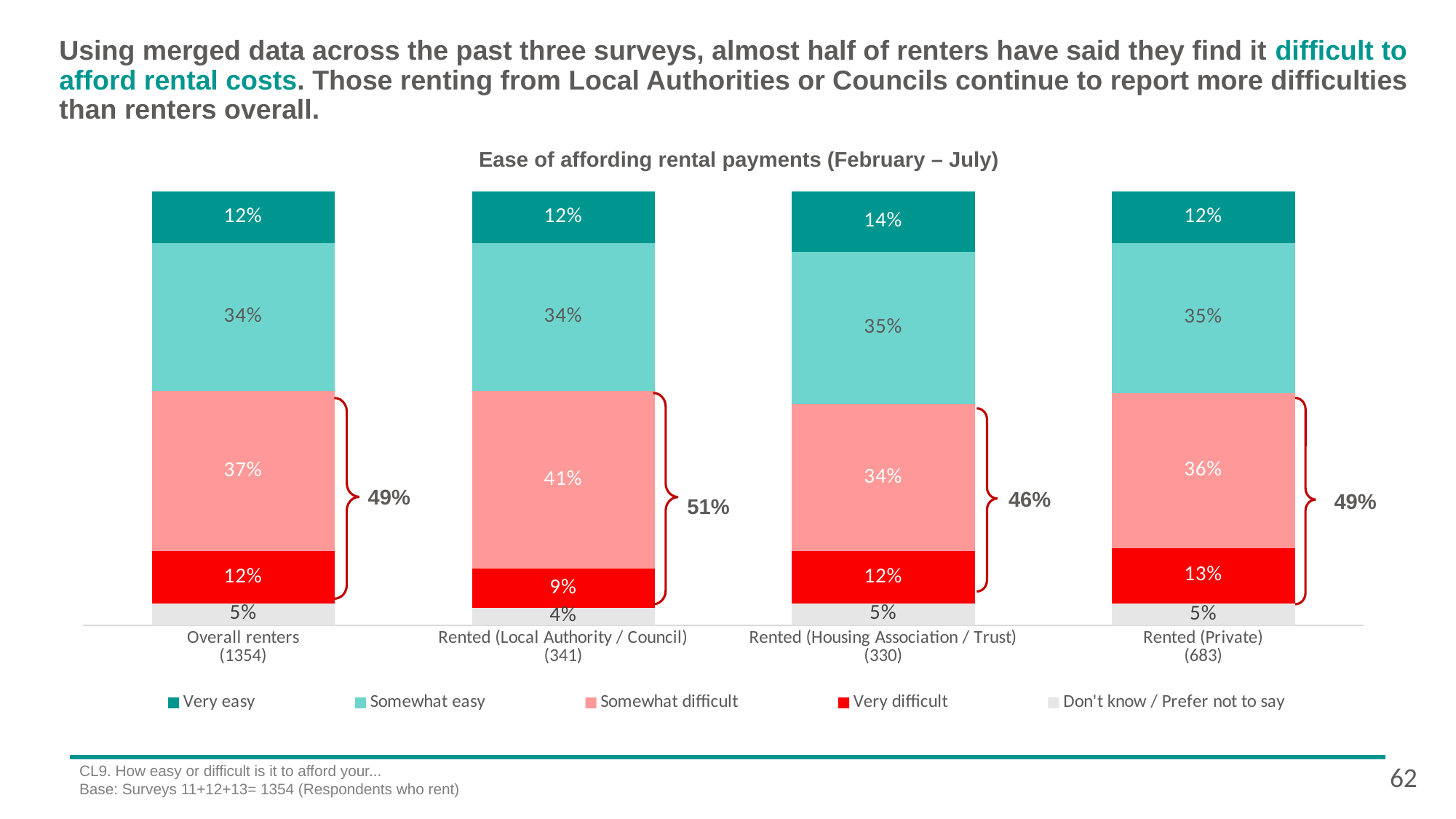
What percentage of Rented (Local Authority / Council) respondents said Very difficult? 9% How many renter categories are shown on the x axis? 4 What percentage of Rented (Housing Association / Trust) respondents said Very easy? 14% What kind of chart is shown on the slide? Stacked bar chart What combined difficult share is shown by the bracket for Rented (Local Authority / Council)? 51% Which is larger: the Very difficult value for Rented (Private) or for Rented (Housing Association / Trust)? Rented (Private) What is the title of the chart? Ease of affording rental payments (February – July) Which category has the highest Somewhat difficult percentage? Rented (Local Authority / Council) What percentage of Overall renters said it is Somewhat difficult to afford rental payments? 37% Which category has the lowest Very difficult percentage? Rented (Local Authority / Council) How many series does the legend list? 5 How many percentage points higher is the Somewhat difficult value for Rented (Local Authority / Council) than for Overall renters? 4